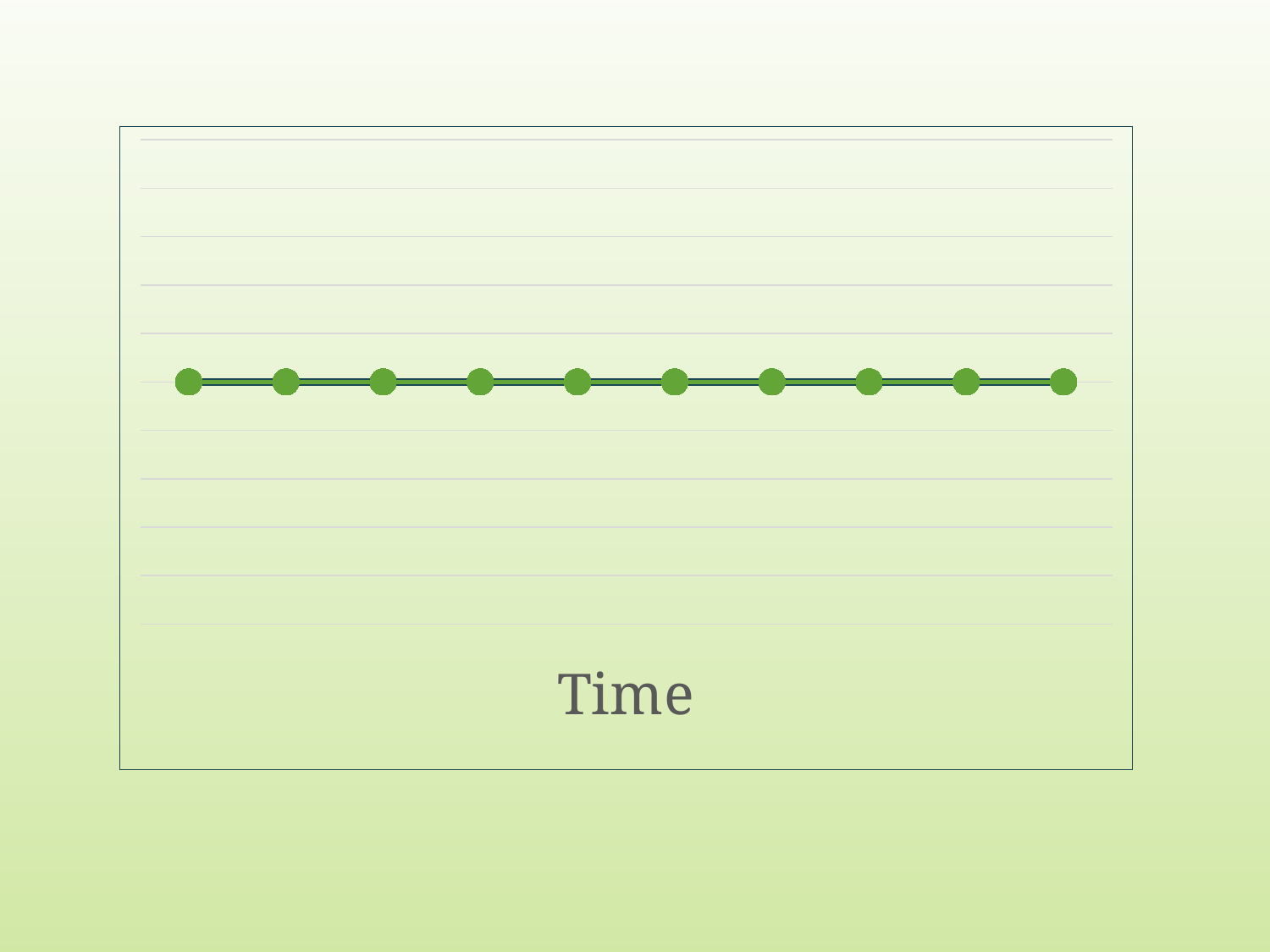
Do the plotted values rise, fall, or stay flat along the x axis? stay flat How many data points are plotted on the line? 10 What kind of chart is shown on the slide? line chart What colour are the line and its markers? green What is the label on the horizontal axis of the chart? Time